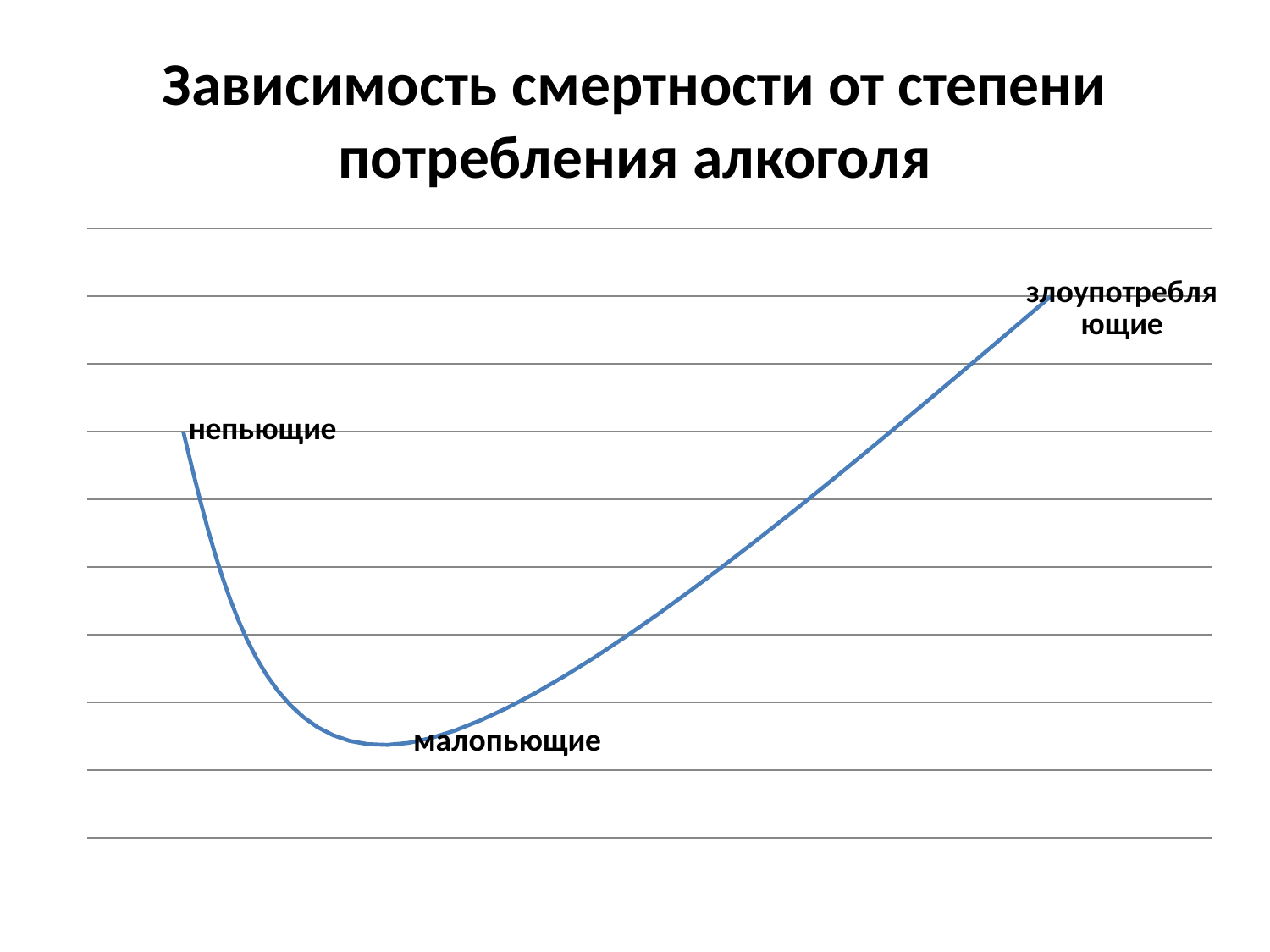
How many labeled points are marked on the line? 3 How does the line change from непьющие to малопьющие? it falls Which labeled group has the lowest value on the line? малопьющие What kind of chart is shown on the slide? line chart How does the line change from малопьющие to злоупотребляющие? it rises Which is higher on the line: злоупотребляющие or непьющие? злоупотребляющие Which labeled group has the highest value on the line? злоупотребляющие What colour is the plotted line? blue Which is higher on the line: непьющие or малопьющие? непьющие What is the title of the chart? Зависимость смертности от степени потребления алкоголя What overall shape does the line follow from left to right? falls then rises (U-shape)